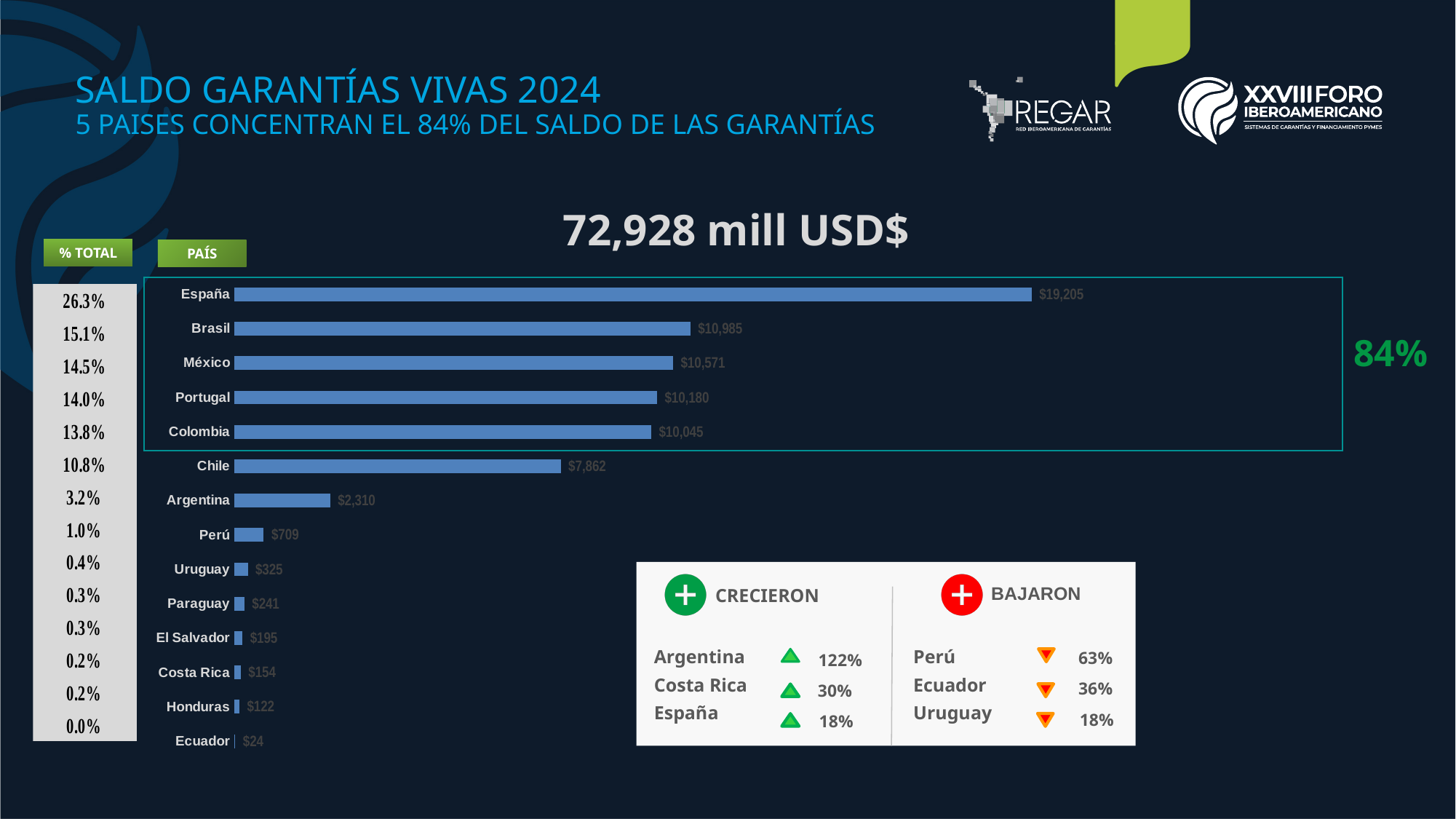
Which has a larger value, Brasil or México? Brasil What is the value shown for Perú? $709 What is the value shown for Colombia? $10,045 Which country has the lowest value in the chart? Ecuador How many countries are shown in the chart? 14 Which country has the highest value in the chart? España What is the difference between the values for Chile and Argentina? $5,552 What total amount is shown above the chart? 72,928 mill USD$ What is the value shown for España? $19,205 What is the difference between the values for España and Brasil? $8,220 What is the value shown for Honduras? $122 What kind of chart is shown on the slide? Bar chart